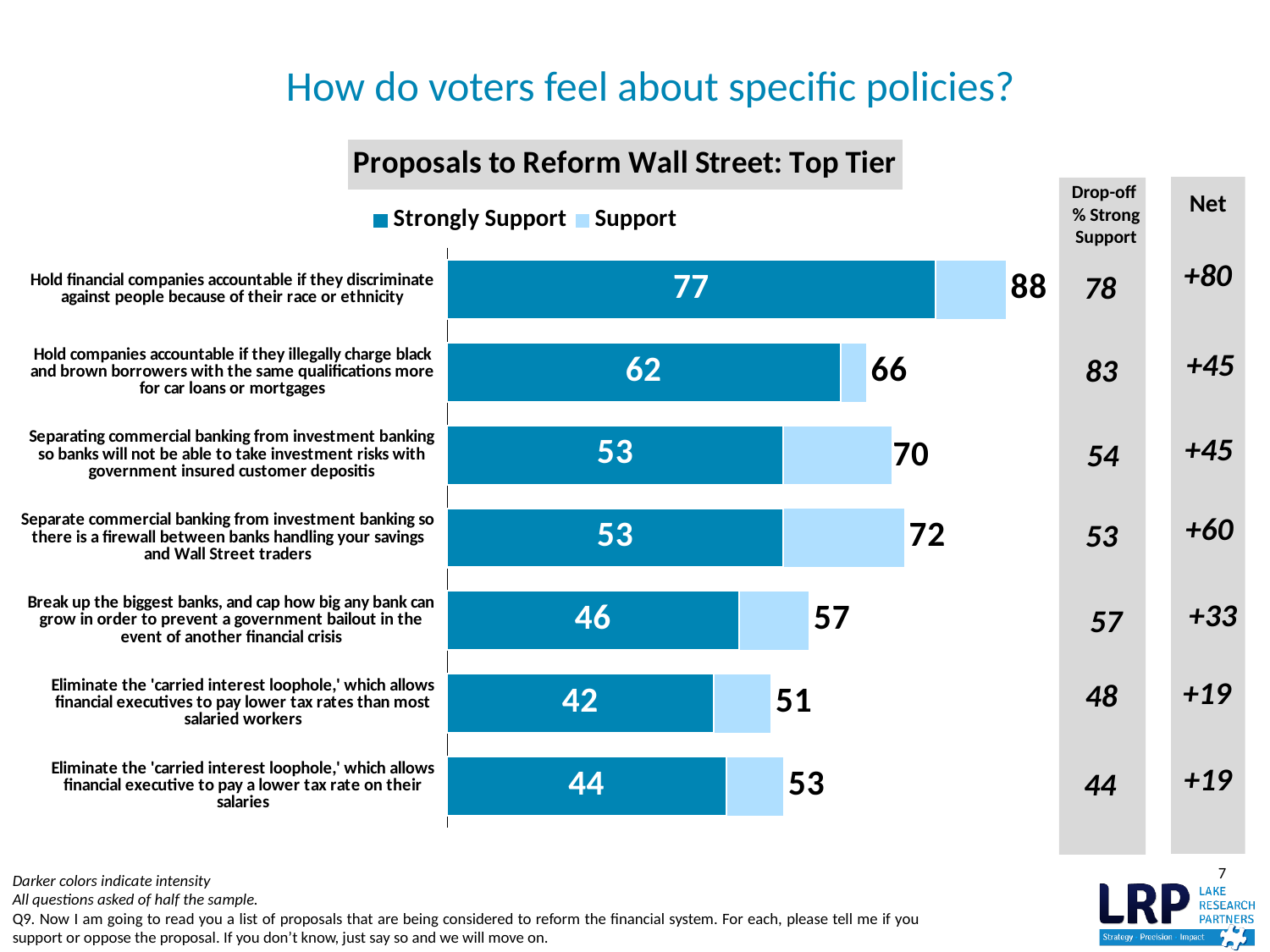
What is the Strongly Support value for 'Break up the biggest banks, and cap how big any bank can grow in order to prevent a government bailout in the event of another financial crisis'? 46 Which has a larger total support: 'Break up the biggest banks, and cap how big any bank can grow in order to prevent a government bailout in the event of another financial crisis' or 'Eliminate the 'carried interest loophole,' which allows financial executive to pay a lower tax rate on their salaries'? Break up the biggest banks, and cap how big any bank can grow in order to prevent a government bailout in the event of another financial crisis Which series is shown in the darker blue colour in the chart? Strongly Support What is the title of the chart? Proposals to Reform Wall Street: Top Tier How many series does the chart legend list? 2 What kind of chart is shown on the slide? Stacked bar chart How many proposals (categories) are plotted in the chart? 7 What is the Strongly Support value for 'Hold financial companies accountable if they discriminate against people because of their race or ethnicity'? 77 Which proposal has the lowest Strongly Support value? Eliminate the 'carried interest loophole,' which allows financial executives to pay lower tax rates than most salaried workers What is the difference between the total support for 'Hold financial companies accountable if they discriminate against people because of their race or ethnicity' (88) and for 'Hold companies accountable if they illegally charge black and brown borrowers with the same qualifications more for car loans or mortgages' (66)? 22 Which proposal has the highest Strongly Support value? Hold financial companies accountable if they discriminate against people because of their race or ethnicity What is the total support (Strongly Support plus Support) shown for 'Separate commercial banking from investment banking so there is a firewall between banks handling your savings and Wall Street traders'? 72